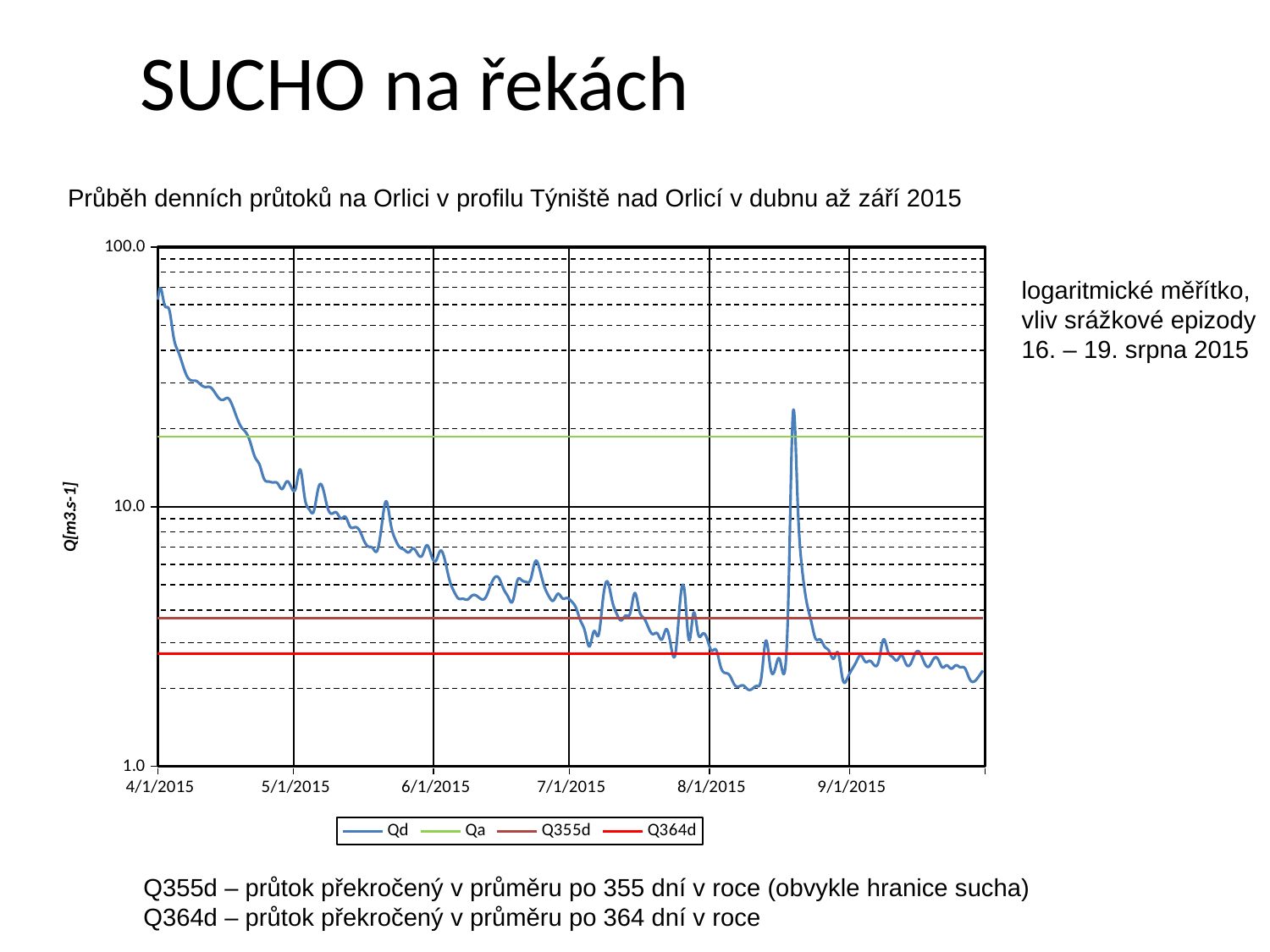
Is the value of Qd at 9/1/2015 greater or less than 10.0? less Is the value of the Qa line greater or less than 10.0? greater Which is larger, the Q355d line or the Q364d line? Q355d What is the label of the y axis? Q[m3.s-1] Which series are listed in the legend? Qd, Qa, Q355d, Q364d Is the value of the Q364d line greater or less than 10.0? less Which of the three horizontal reference lines (Qa, Q355d, Q364d) has the highest value? Qa How many dates are labeled on the x axis? 6 How many series does the legend list? 4 Does the Qd series overall rise or fall from 4/1/2015 to 9/1/2015? fall What kind of chart is shown on the slide? line chart